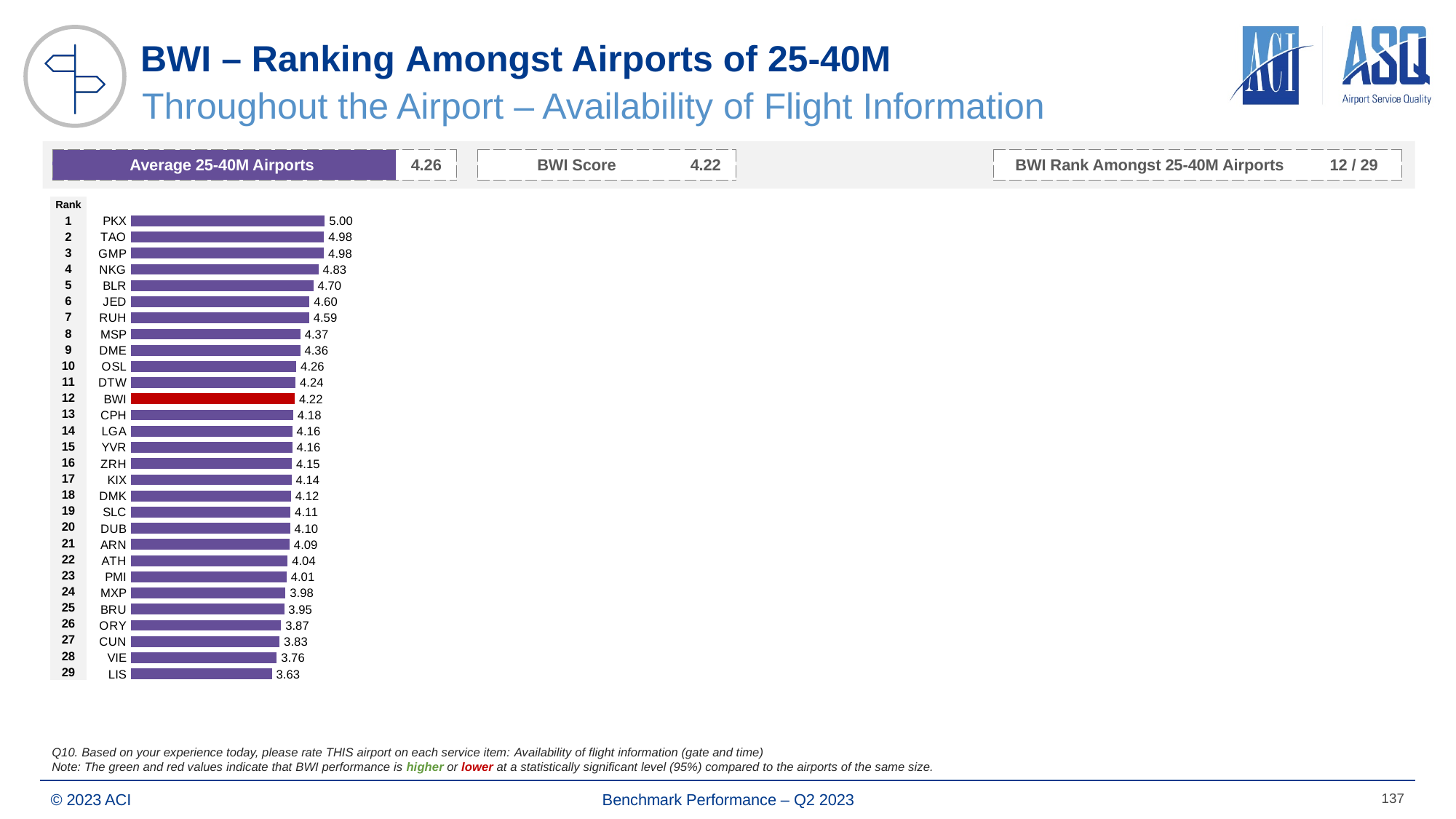
Do the values rise or fall going down the ranking from rank 1 to rank 29? Fall What kind of chart is shown? Bar chart How many airports are ranked in the chart? 29 Which airport's bar is coloured red? BWI Which airport has the lowest value? LIS What is the difference between the values for BWI and DTW? 0.02 Which airport has the highest value? PKX What is the value for MSP? 4.37 What is the value for ORY? 3.87 Which has a larger value, JED or CUN? JED What is the difference between the values for PKX and LIS? 1.37 What is the value for BWI? 4.22